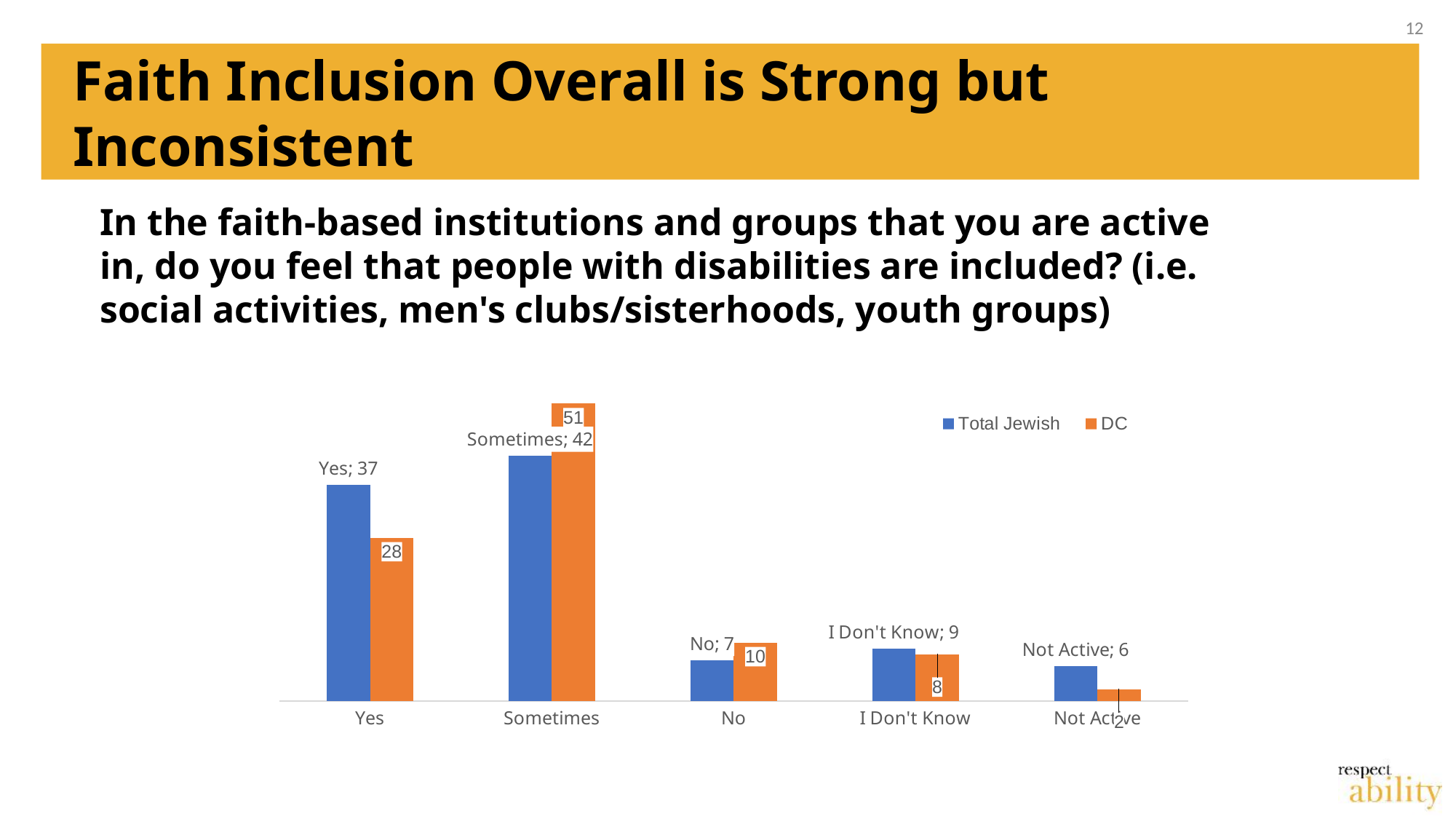
What is the DC value for Yes? 28 What is the Total Jewish value for Sometimes? 42 How many categories are shown on the x axis? 5 What kind of chart is shown on the slide? Bar chart What is the Total Jewish value for Not Active? 6 How many series does the legend list? 2 What is the DC value for No? 10 What is the difference between the DC and Total Jewish values for Sometimes? 9 Which category has the lowest DC value? Not Active Which is larger for Yes: the Total Jewish value or the DC value? Total Jewish Which series is shown in orange? DC Which category has the highest DC value? Sometimes